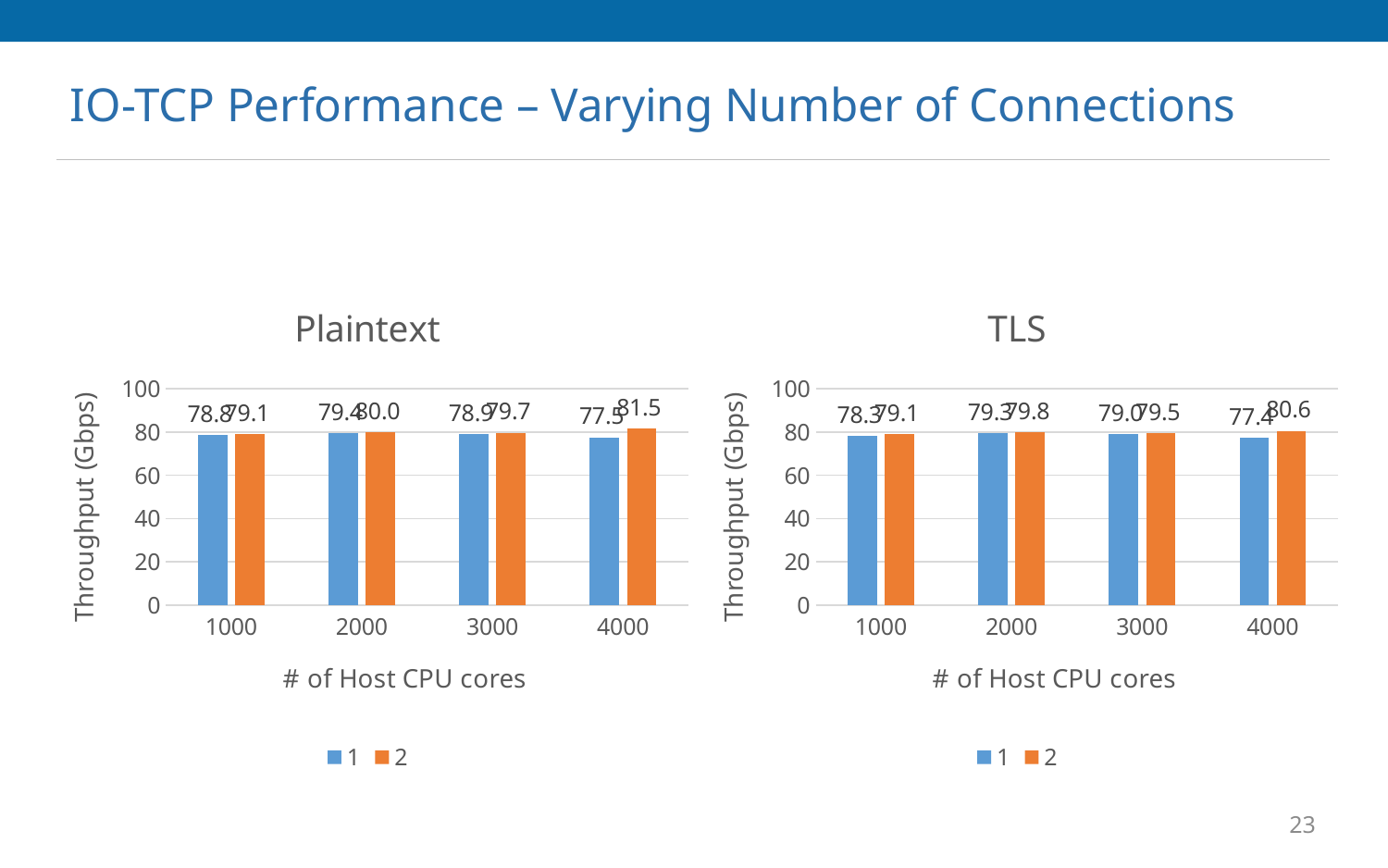
In the TLS chart, what is the throughput for series 2 at 1000 host CPU cores? 79.1 In the Plaintext chart, what is the throughput for series 2 at 4000 host CPU cores? 81.5 How many series does the legend of the TLS chart list? 2 How many host CPU core categories are shown on the x axis of the Plaintext chart? 4 What kind of chart is the Plaintext chart? bar chart In the TLS chart, at 4000 host CPU cores, which series has the larger throughput, series 1 or series 2? series 2 In the Plaintext chart, is the throughput for series 1 at 4000 host CPU cores greater or less than 80? less In the TLS chart, at which number of host CPU cores does series 2 reach its highest throughput? 4000 In the TLS chart, what is the throughput for series 2 at 4000 host CPU cores? 80.6 In the Plaintext chart, what is the difference between the series 2 throughput at 4000 cores and at 2000 cores? 1.5 In the Plaintext chart, what is the throughput for series 2 at 2000 host CPU cores? 80.0 In the Plaintext chart, at which number of host CPU cores does series 2 reach its highest throughput? 4000